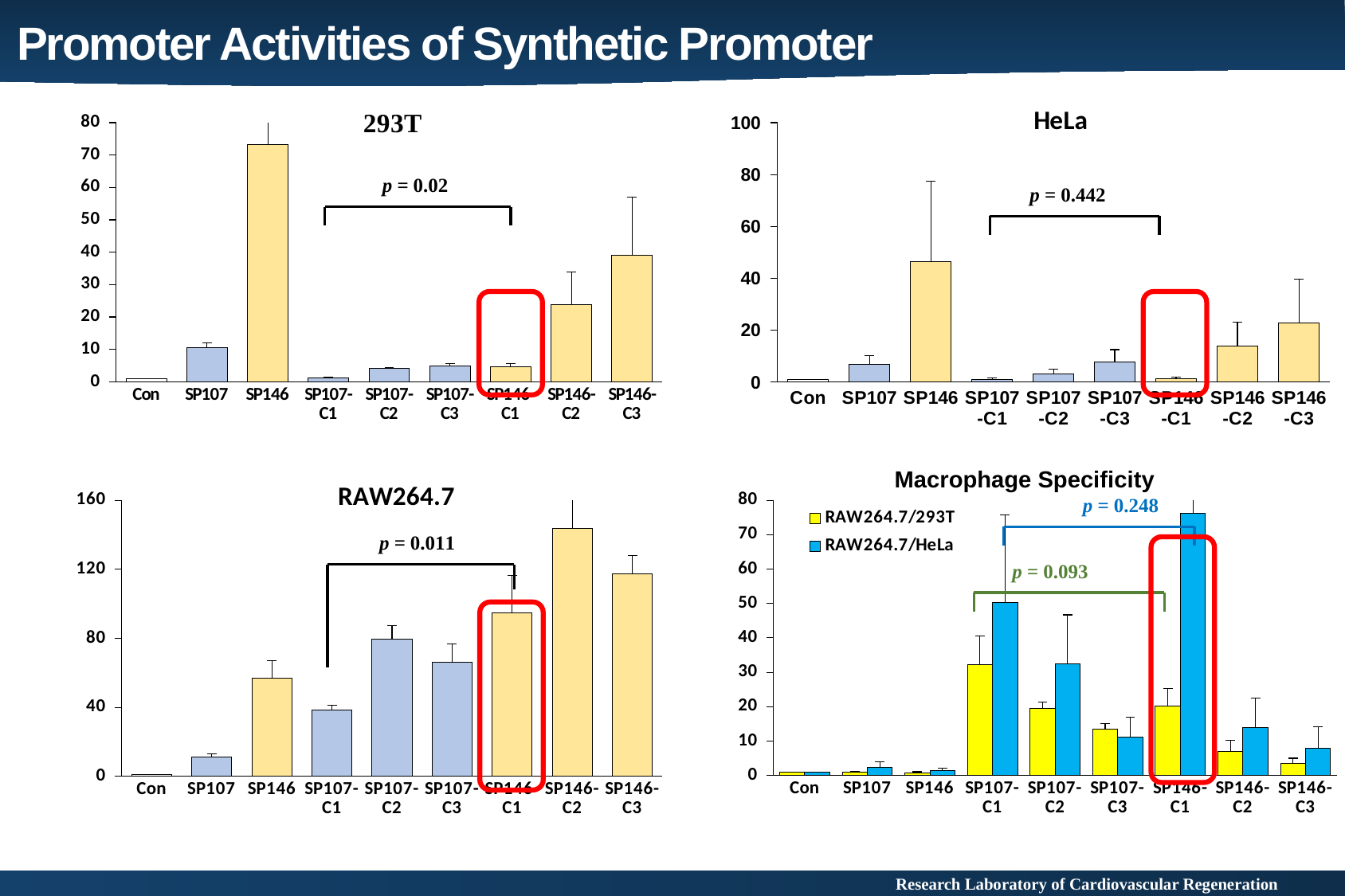
In the HeLa chart, which is larger, the value for SP146-C2 or SP146-C3? SP146-C3 In the RAW264.7 chart, which category has the highest bar? SP146-C2 How many series does the legend of the Macrophage Specificity chart list? 2 What p-value is annotated on the 293T chart? p = 0.02 In the RAW264.7 chart, is the value for SP146-C1 greater or less than 80? greater How many categories are shown on the x axis of the HeLa chart? 9 In the 293T chart, is the value for SP146-C2 greater or less than 20? greater In the Macrophage Specificity chart, which category has the highest RAW264.7/HeLa bar? SP146-C1 In the RAW264.7 chart, which is larger, the value for SP107-C2 or SP107-C3? SP107-C2 In the 293T chart, is the value for SP146 greater or less than 60? greater In the 293T chart, which category has the highest bar? SP146